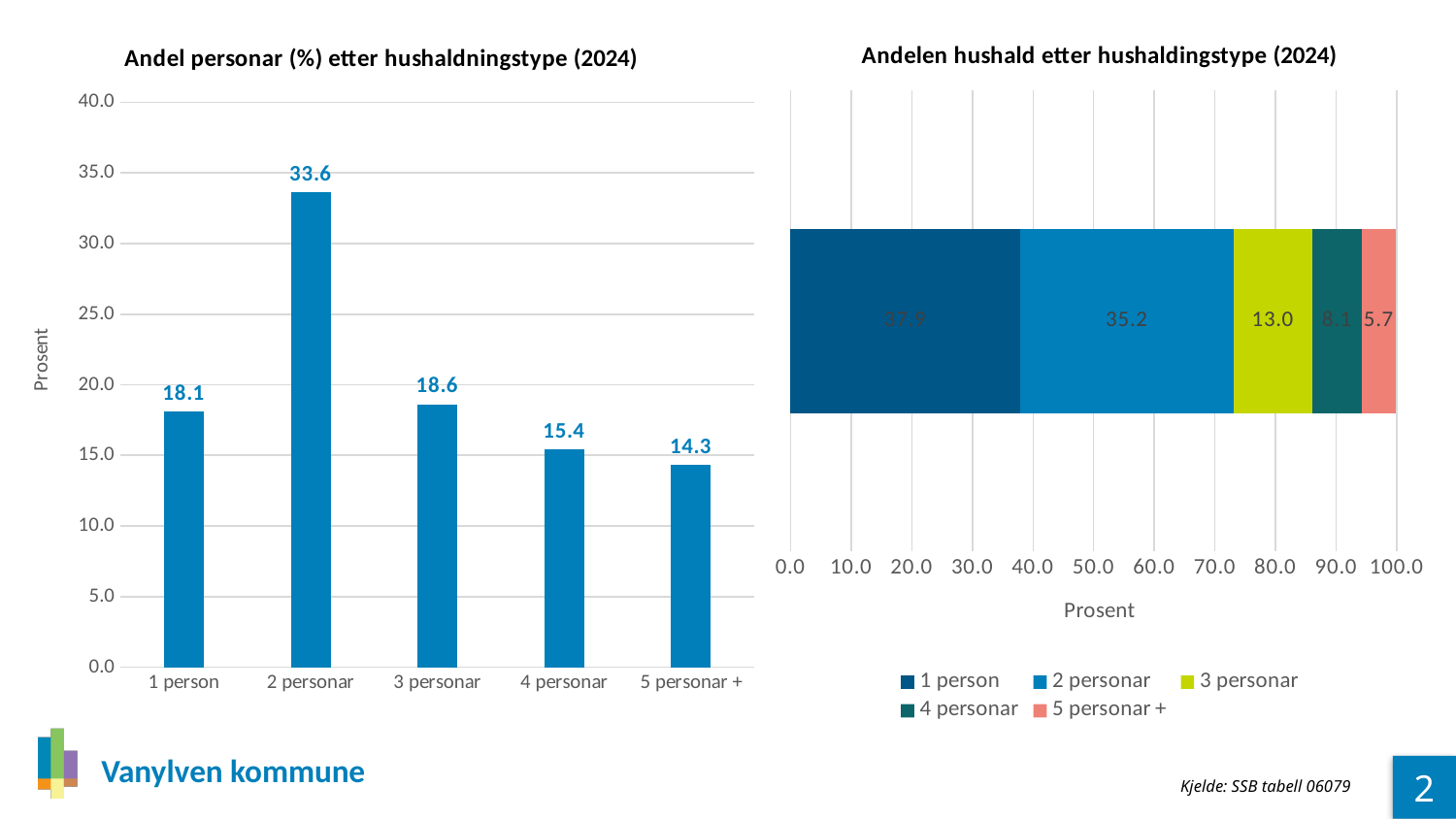
In the chart titled 'Andel personar (%) etter hushaldningstype (2024)', what is the value for 1 person? 18.1 In the chart titled 'Andelen hushald etter hushaldingstype (2024)', what is the value for 3 personar? 13.0 In the chart titled 'Andel personar (%) etter hushaldningstype (2024)', what is the value for 2 personar? 33.6 In the chart titled 'Andel personar (%) etter hushaldningstype (2024)', what is the difference between the values for 2 personar and 3 personar? 15.0 In the chart titled 'Andel personar (%) etter hushaldningstype (2024)', which category has the highest value? 2 personar How many series does the legend of the chart titled 'Andelen hushald etter hushaldingstype (2024)' list? 5 In the chart titled 'Andelen hushald etter hushaldingstype (2024)', what is the value for 2 personar? 35.2 In the chart titled 'Andel personar (%) etter hushaldningstype (2024)', which category has the lowest value? 5 personar + In the chart titled 'Andelen hushald etter hushaldingstype (2024)', what is the value for 5 personar +? 5.7 In the chart titled 'Andel personar (%) etter hushaldningstype (2024)', which is larger: the value for 4 personar or the value for 5 personar +? 4 personar In the chart titled 'Andel personar (%) etter hushaldningstype (2024)', how many categories are shown on the x axis? 5 What kind of chart is the chart titled 'Andel personar (%) etter hushaldningstype (2024)'? Bar chart